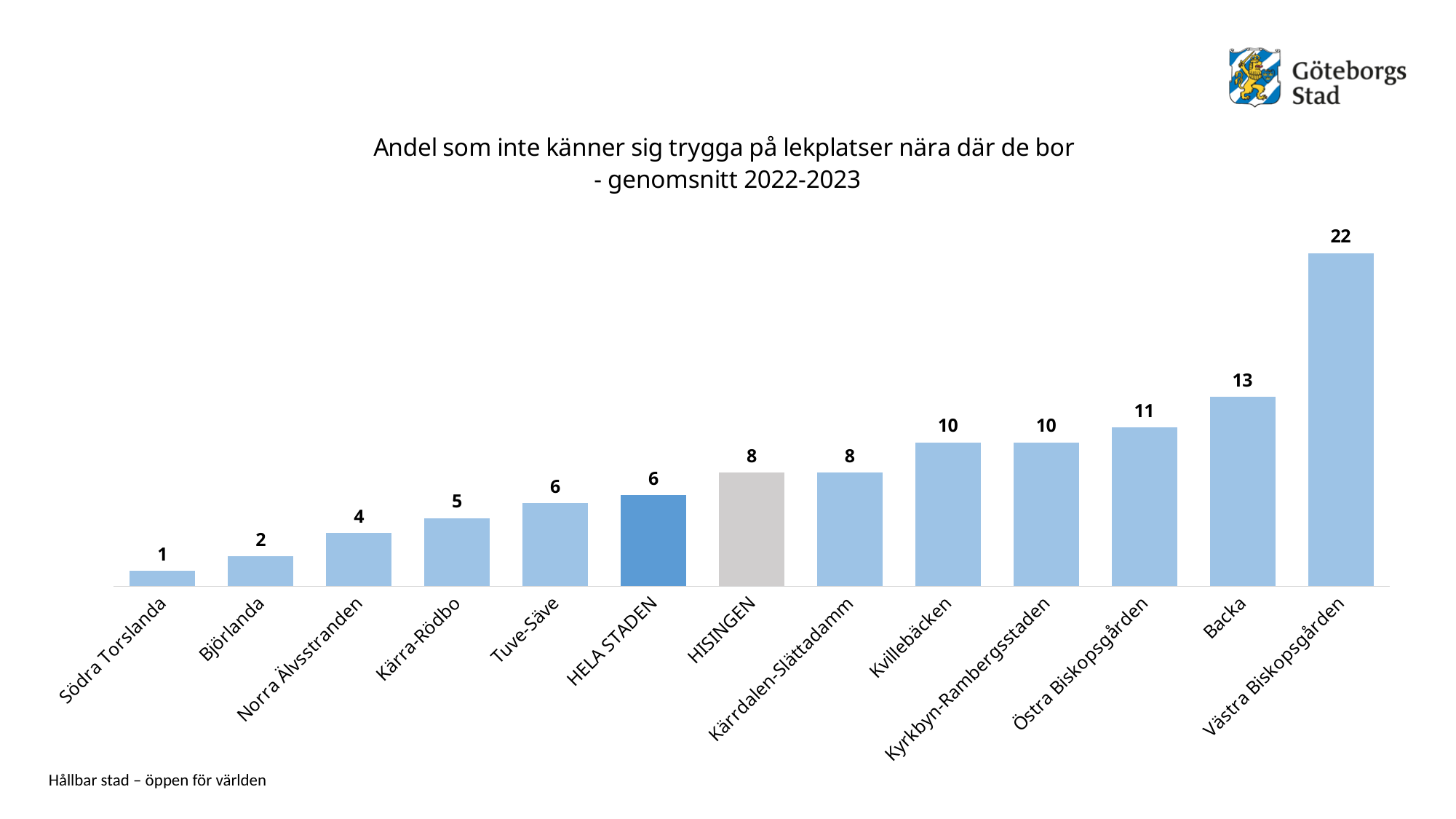
Which category has the lowest value? Södra Torslanda What is the value for HELA STADEN? 6 How many categories are shown on the x axis? 13 What is the difference between the values for HISINGEN and HELA STADEN? 2 What is the value for Kärra-Rödbo? 5 What is the difference between the values for Västra Biskopsgården and Backa? 9 What is the value for Västra Biskopsgården? 22 What is the value for HISINGEN? 8 Which category has the highest value? Västra Biskopsgården Which has a larger value, Kvillebäcken or Tuve-Säve? Kvillebäcken Do the values rise or fall from left to right along the x axis? Rise What kind of chart is this? Bar chart